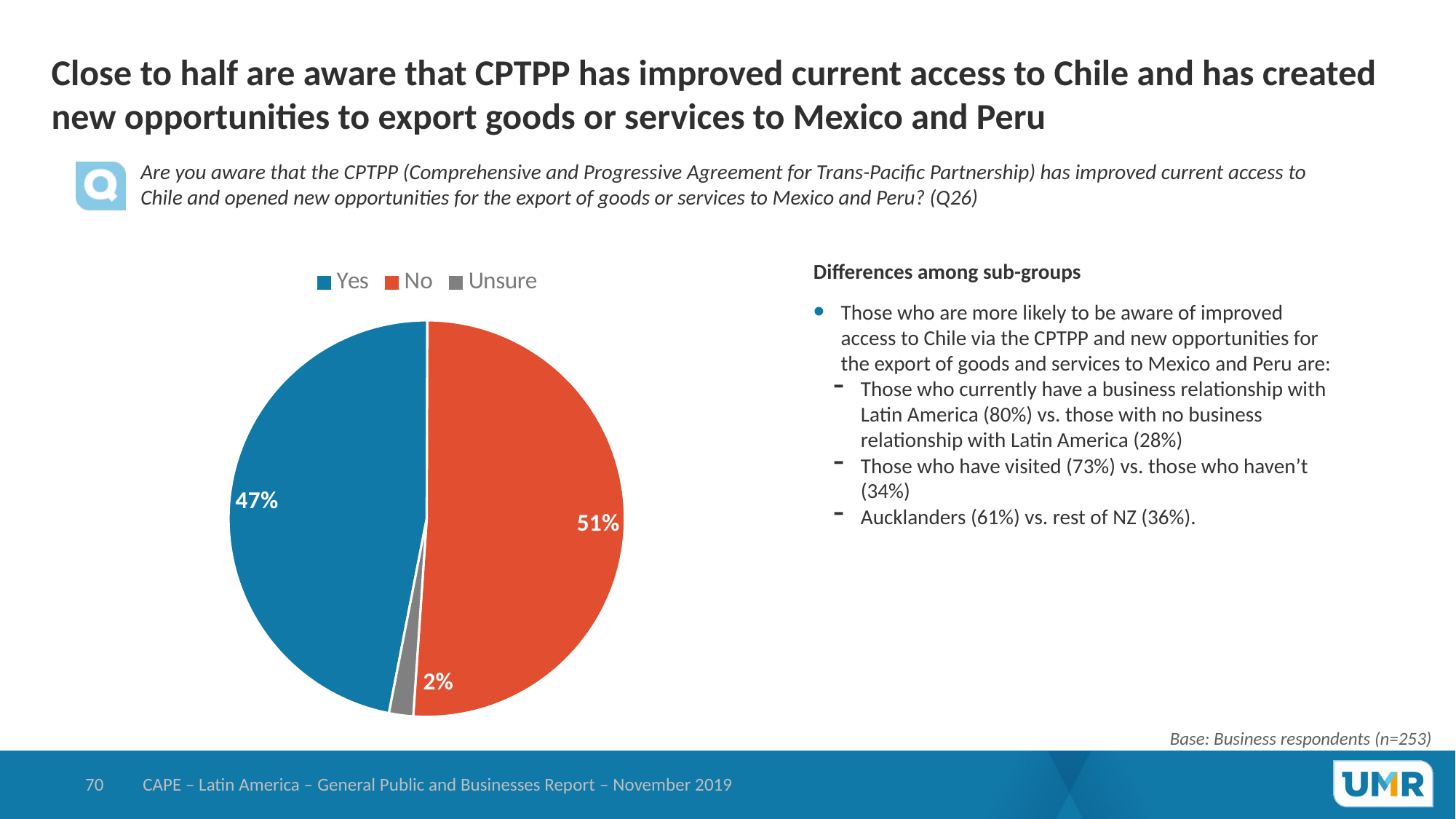
What colour is the Unsure slice in the pie chart? Grey Which response has the largest share of the pie? No Which is larger, the Yes slice or the No slice? No How many entries does the legend list? 3 Which response has the smallest share of the pie? Unsure What colour is the Yes slice in the pie chart? Blue What is the difference in percentage points between the No and Yes slices? 4 What percentage of respondents answered No? 51% What percentage of respondents answered Yes? 47% What kind of chart is shown on the slide? Pie chart What percentage of respondents answered Unsure? 2% How many slices does the pie chart have? 3